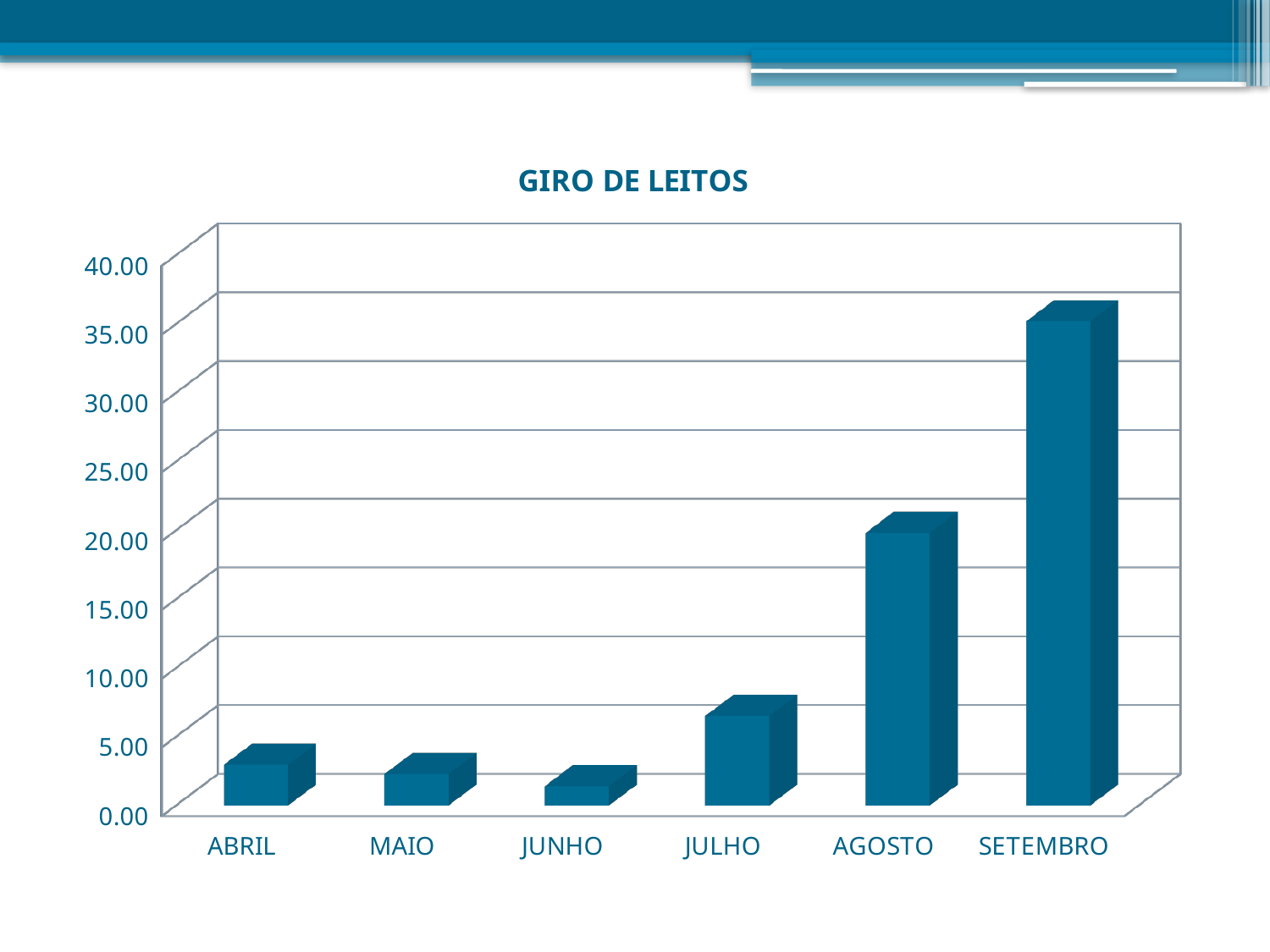
From JUNHO to SETEMBRO, do the values rise or fall? rise What is the title of the chart? GIRO DE LEITOS Is the value for SETEMBRO greater or less than 30.00? greater How many months are shown on the x axis of the chart? 6 Which month has the lowest value in the chart? JUNHO Is the value for AGOSTO greater or less than 15.00? greater Which is larger, the value for ABRIL or the value for JUNHO? ABRIL Which is larger, the value for AGOSTO or the value for JULHO? AGOSTO What kind of chart is shown on the slide? bar chart Which month has the highest value in the chart? SETEMBRO Is the value for JULHO greater or less than 10.00? less